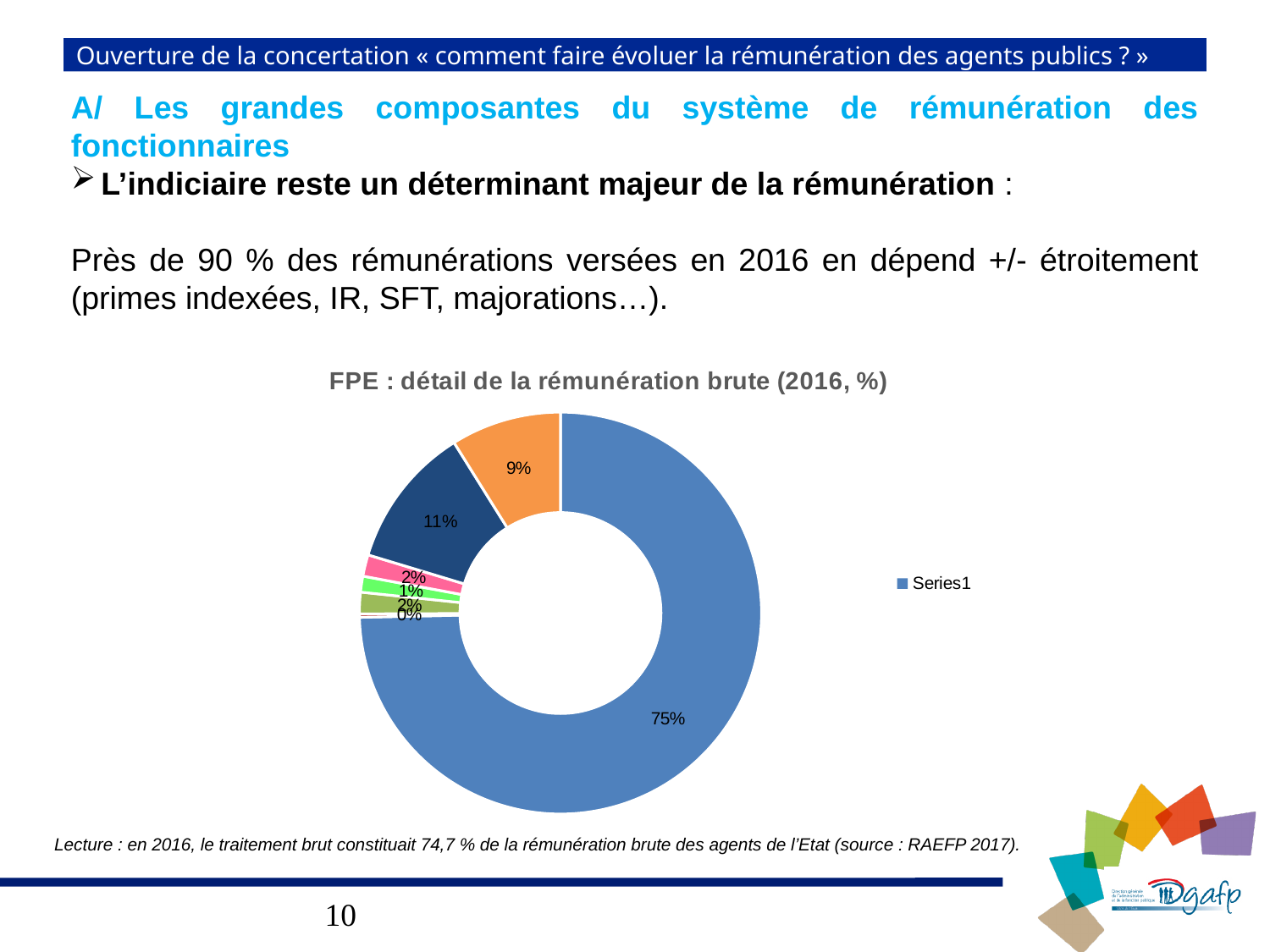
What is the name of the series shown in the legend? Series1 What is the difference between the largest slice (75%) and the dark navy slice (11%)? 64% What is the value of the largest slice of the doughnut chart? 75% Which slice is larger, the orange slice or the dark navy slice? the dark navy slice How many slices are labelled on the doughnut chart? 7 What kind of chart is shown on the slide? doughnut chart What is the value of the smallest slice of the doughnut chart? 0% What share of the doughnut does the large blue slice represent? 75% What is the value of the dark navy slice? 11% What is the title of the chart? FPE : détail de la rémunération brute (2016, %) How many series does the chart legend list? 1 What is the value of the orange slice? 9%